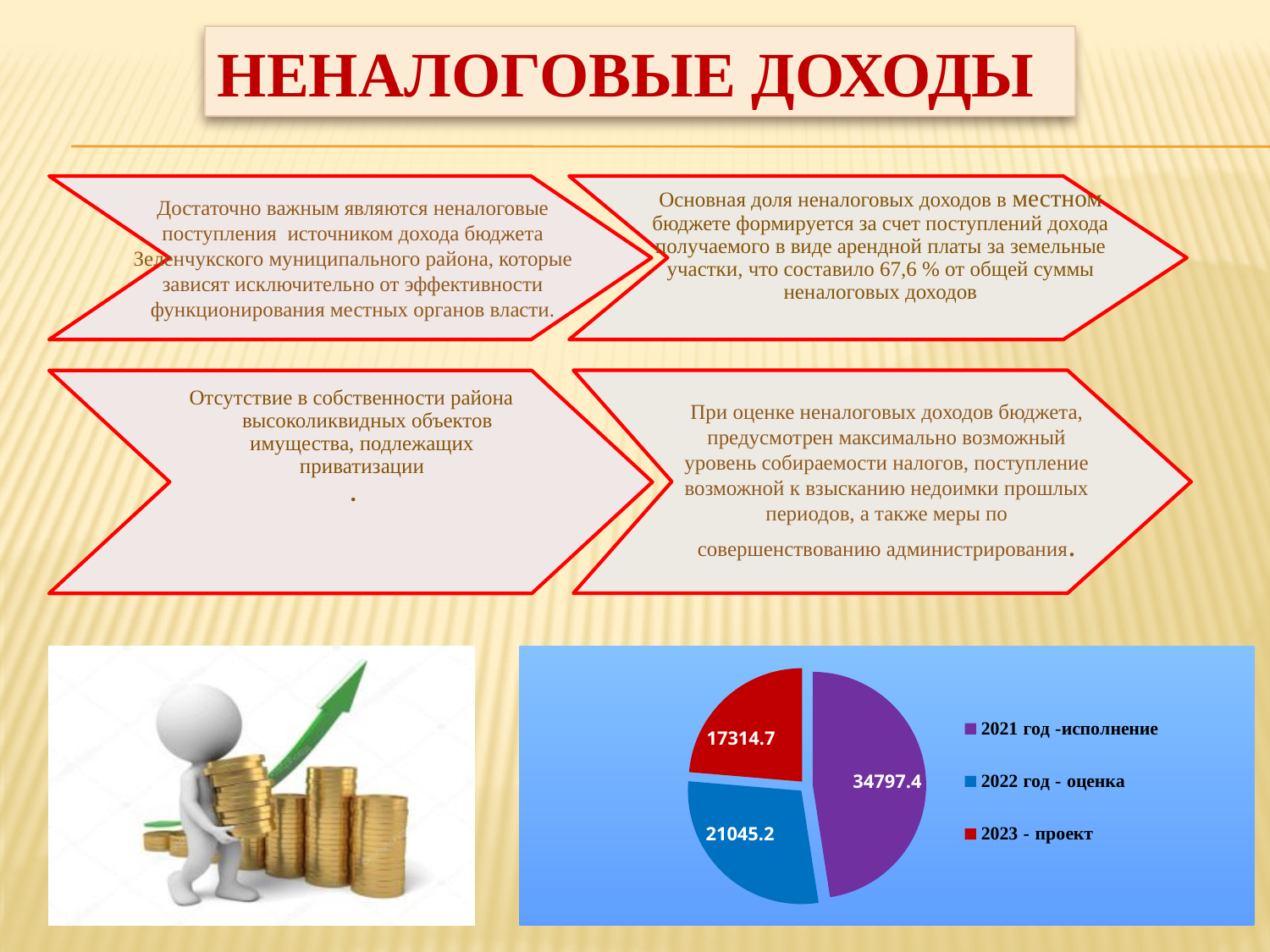
In the pie chart, what is the value for 2021 год -исполнение? 34797.4 In the pie chart, what is the value for 2023 - проект? 17314.7 Which category has the largest slice in the pie chart? 2021 год -исполнение What colour is the slice for 2023 - проект in the pie chart? red In the pie chart, what is the value for 2022 год - оценка? 21045.2 How many slices does the pie chart have? 3 What type of chart is shown at the bottom right of the slide? pie chart In the pie chart, what is the difference between the values for 2022 год - оценка and 2023 - проект? 3730.5 In the pie chart, what is the difference between the values for 2021 год -исполнение and 2022 год - оценка? 13752.2 What is the total of all three values shown in the pie chart? 73157.3 Which category has the smallest slice in the pie chart? 2023 - проект In the pie chart, which is larger: the value for 2022 год - оценка or the value for 2023 - проект? 2022 год - оценка